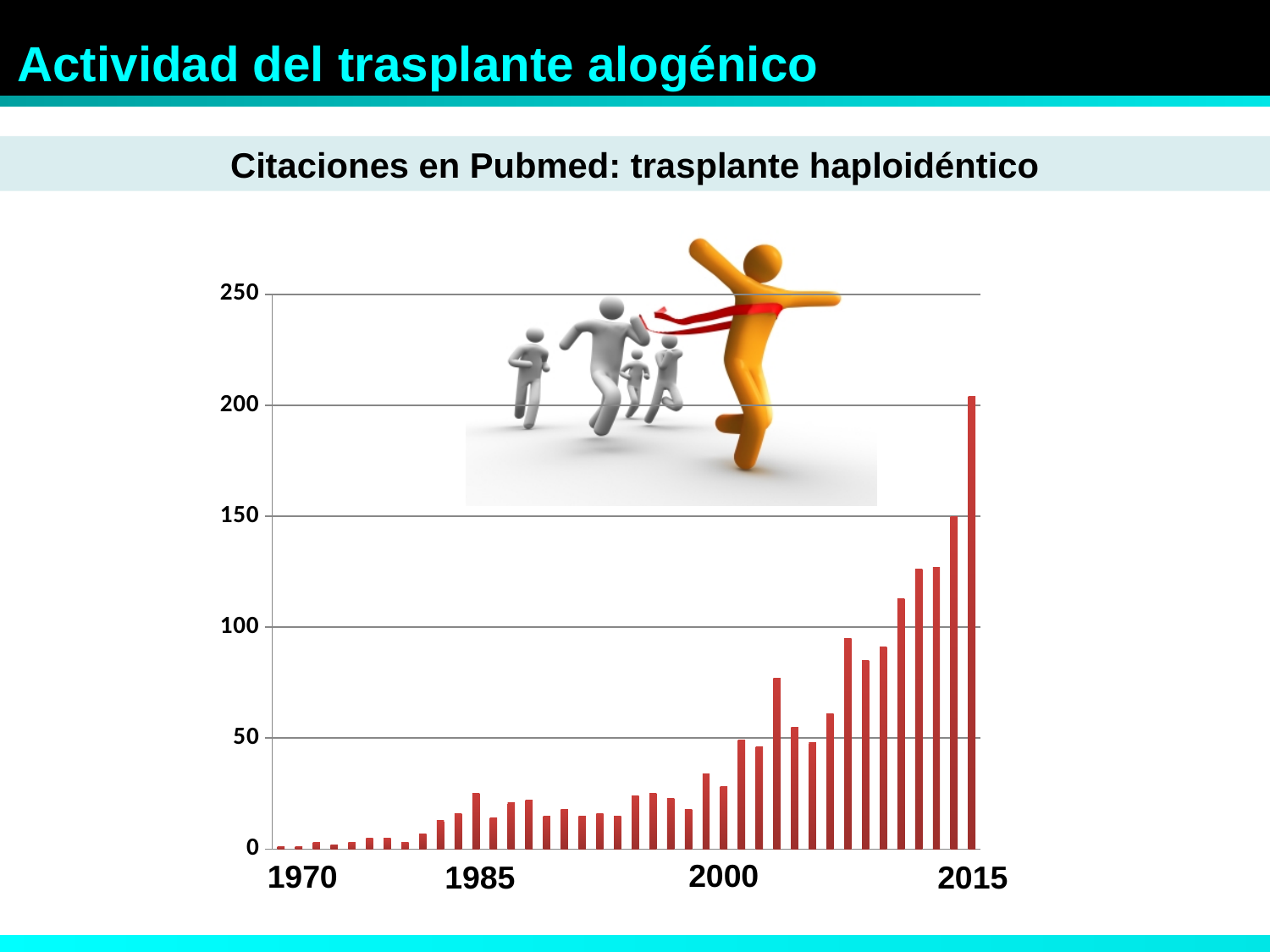
How many year labels are shown on the x axis? 4 What is the highest value shown on the y axis? 250 Is the value for 2015 greater or less than 200? greater Is the value for 2000 greater or less than 50? less Which year has the tallest bar in the chart? 2015 Do the values generally rise or fall from 1970 to 2015? rise What kind of chart is shown on the slide? bar chart Which year has the larger value, 2000 or 2015? 2015 Is the value for 1985 greater or less than 50? less What is the title of the chart? Citaciones en Pubmed: trasplante haploidéntico